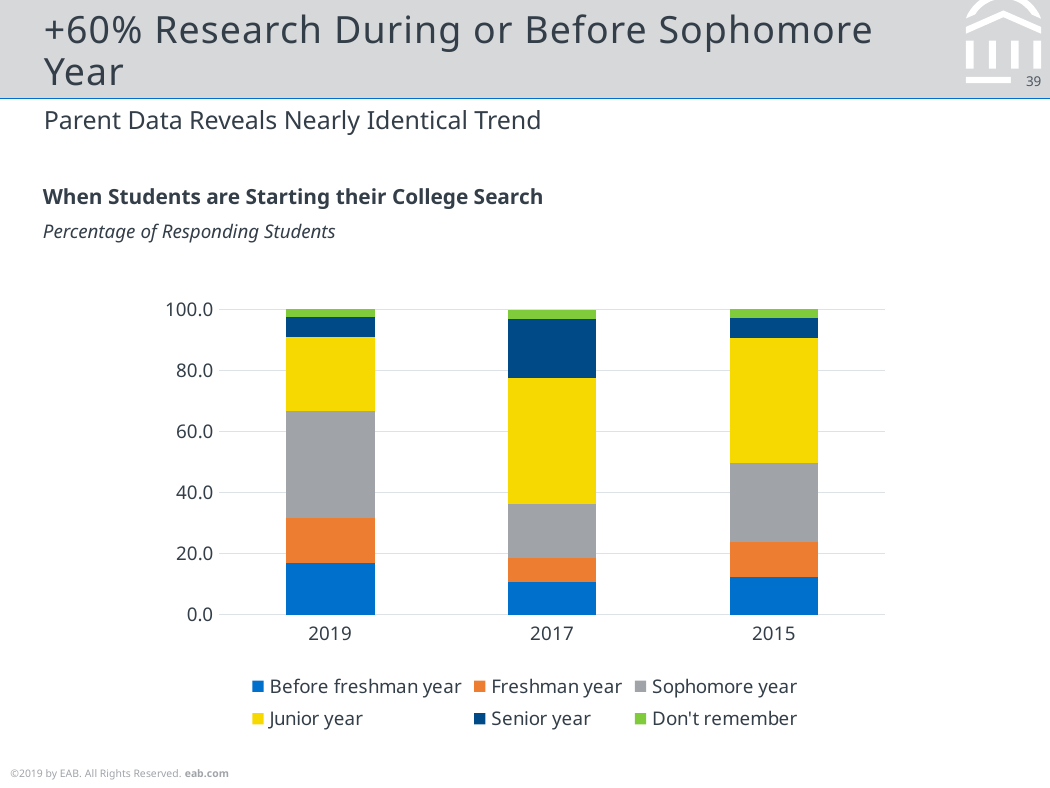
What is the title of the chart? When Students are Starting their College Search Is the 'Junior year' segment larger in 2017 or in 2019? 2017 Is the 'Before freshman year' value for 2019 greater or less than 20? less What kind of chart is shown on the slide? Stacked bar chart Which year has the largest 'Before freshman year' segment? 2019 Is the 'Sophomore year' segment larger in 2019 or in 2017? 2019 Which year has the largest 'Sophomore year' segment? 2019 Which year has the largest 'Senior year' segment? 2017 Which colour represents 'Junior year' in the chart? Yellow How many series does the chart's legend list? 6 Is the 'Before freshman year' value for 2017 greater or less than 20? less How many years are shown on the x axis of the chart? 3